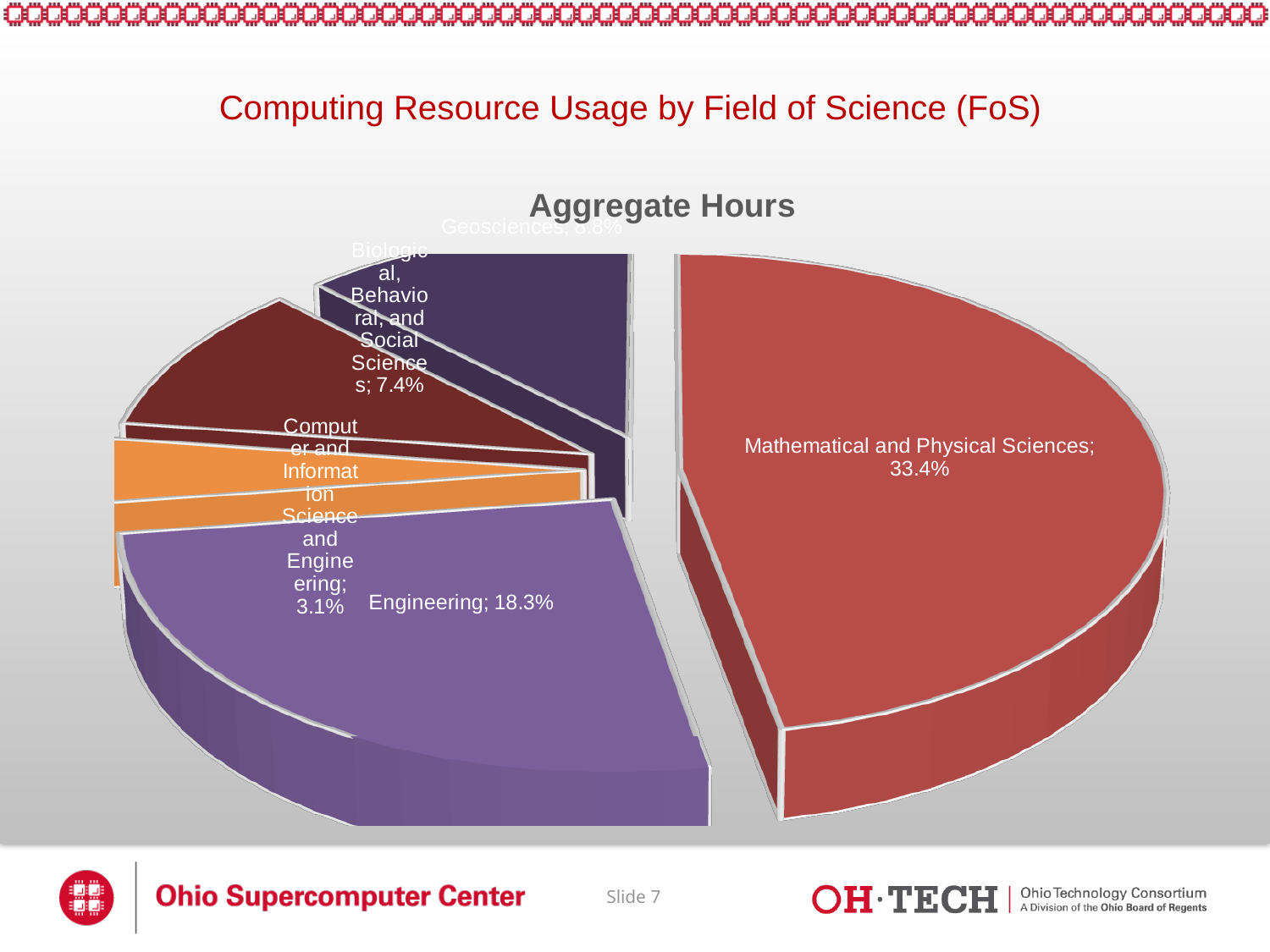
By how many percentage points does the Mathematical and Physical Sciences share exceed the Engineering share? 15.1 percentage points What is the title of the chart? Aggregate Hours What share of aggregate hours is attributed to Computer and Information Science and Engineering? 3.1% Of the labeled slices, which field has the smallest share of aggregate hours? Computer and Information Science and Engineering By how many percentage points does the Biological, Behavioral, and Social Sciences share exceed the Computer and Information Science and Engineering share? 4.3 percentage points Which has a larger share of aggregate hours, Engineering or Biological, Behavioral, and Social Sciences? Engineering What colour is the Mathematical and Physical Sciences slice? Red What share of aggregate hours is attributed to Engineering? 18.3% What share of aggregate hours is attributed to Biological, Behavioral, and Social Sciences? 7.4% What share of aggregate hours is attributed to Mathematical and Physical Sciences? 33.4% What kind of chart is shown on the slide? Pie chart Which field of science has the largest share of aggregate hours? Mathematical and Physical Sciences